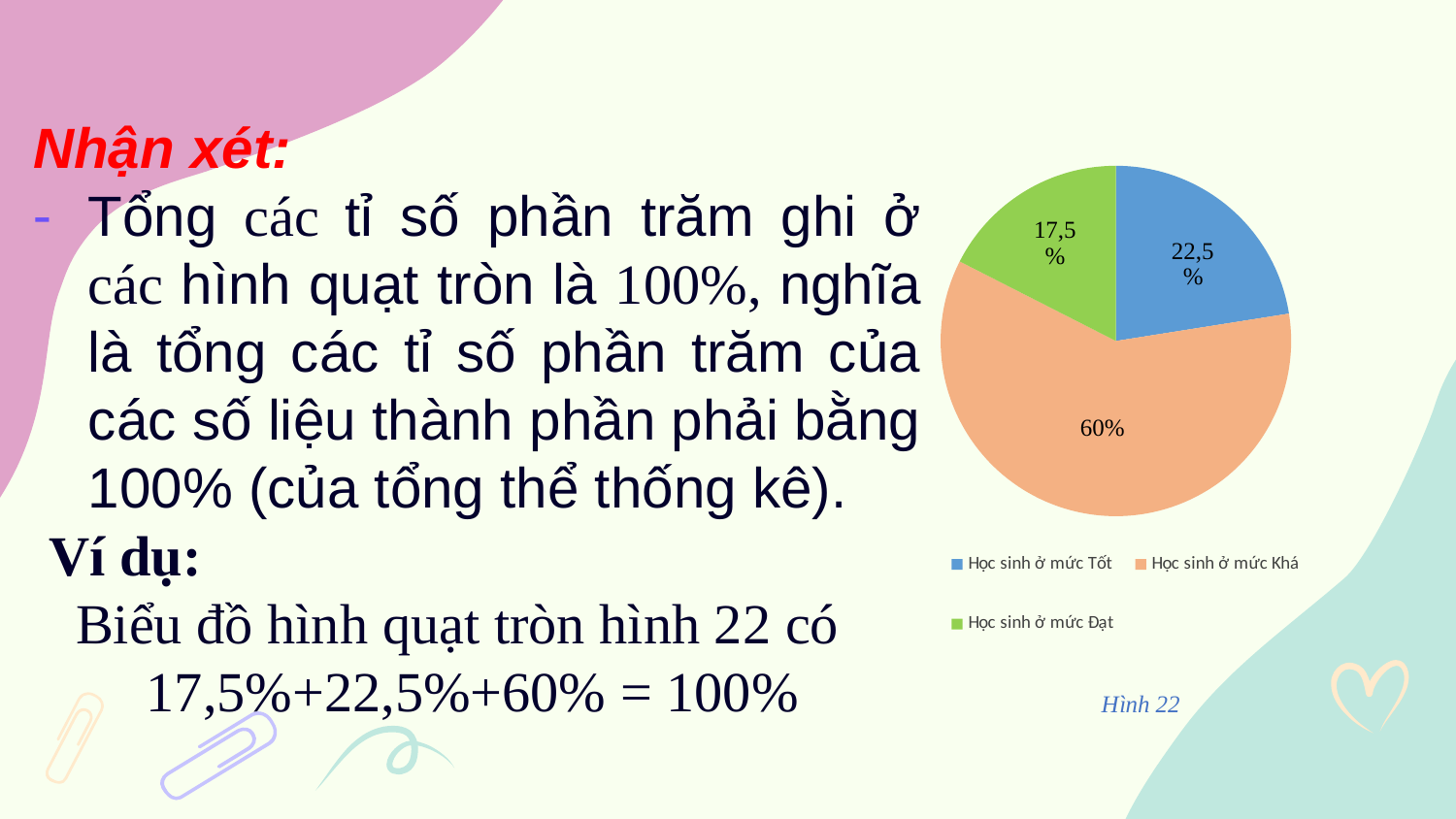
Which category has the largest slice of the pie? Học sinh ở mức Khá What is the difference between the percentages for Học sinh ở mức Khá and Học sinh ở mức Tốt? 37,5% What percentage is shown for Học sinh ở mức Đạt? 17,5% What kind of chart is shown on the slide? pie chart What percentage is shown for Học sinh ở mức Tốt? 22,5% What is the figure caption below the pie chart? Hình 22 What colour is the slice for Học sinh ở mức Khá? orange How many slices does the pie chart have? 3 How many entries does the legend list? 3 Which is larger, the slice for Học sinh ở mức Tốt or the slice for Học sinh ở mức Đạt? Học sinh ở mức Tốt What percentage is shown for Học sinh ở mức Khá? 60% Which category has the smallest slice of the pie? Học sinh ở mức Đạt